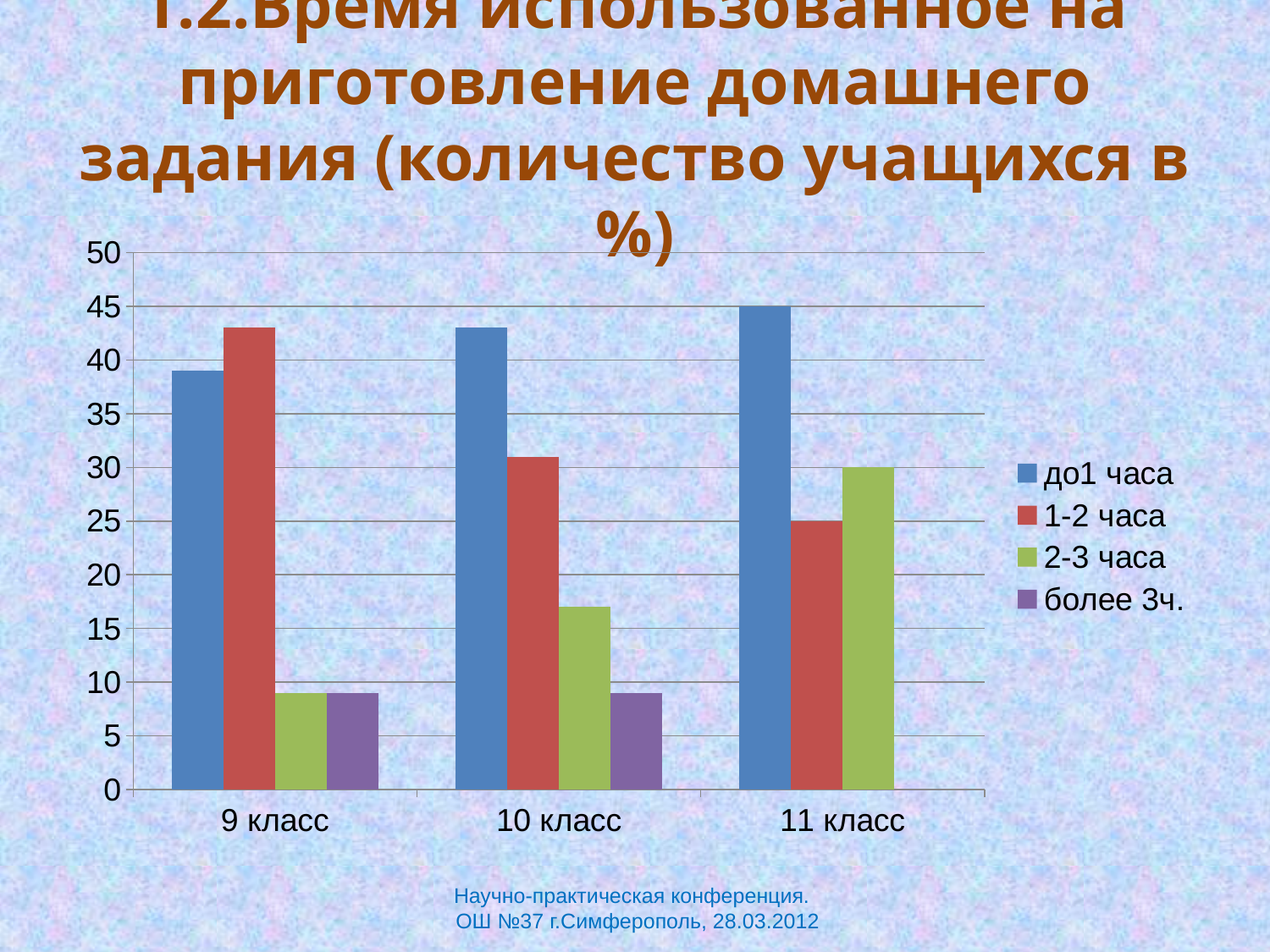
How many series does the legend list? 4 What kind of chart is shown on the slide? bar chart Which series has the lowest value in 10 класс? более 3ч. Is the value for "2-3 часа" in 10 класс greater or less than 20? less Which is larger in 10 класс: "до1 часа" or "1-2 часа"? до1 часа How many class categories are shown on the x axis? 3 Is the value for "до1 часа" in 9 класс greater or less than 35? greater What is the value for "до1 часа" in 11 класс? 45 Which series has the highest value in 9 класс? 1-2 часа Does the value for "до1 часа" rise or fall from 9 класс to 11 класс? rise What is the value for "1-2 часа" in 11 класс? 25 What is the value for "2-3 часа" in 11 класс? 30